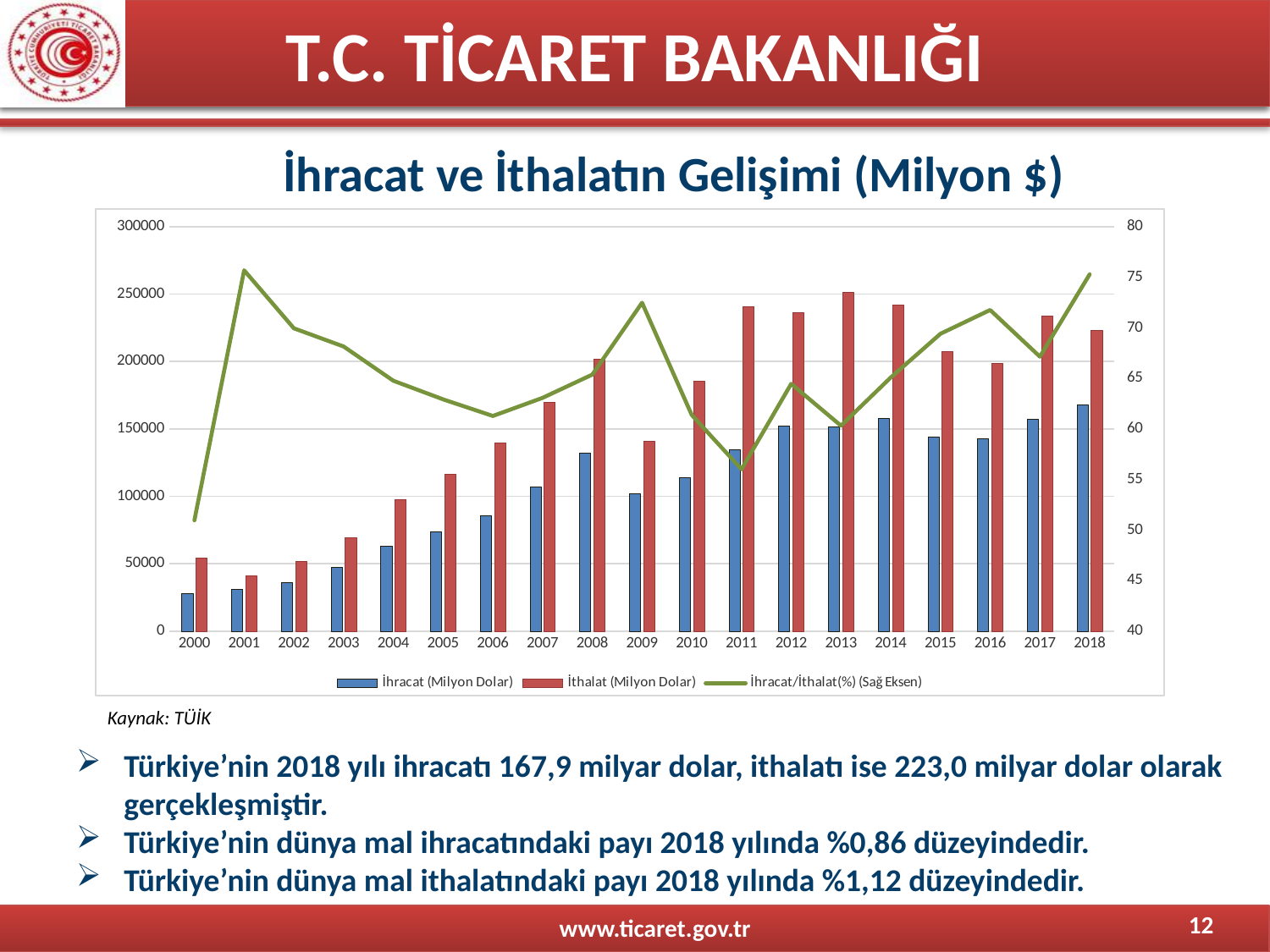
How many series does the legend list? 3 Is the İhracat/İthalat(%) value for 2011 greater or less than 60? less In which year is the İhracat (Milyon Dolar) bar the highest? 2018 What kind of chart is shown on the slide? A combined bar and line chart In which year is the İhracat/İthalat(%) line at its lowest point? 2000 In which year is the İthalat (Milyon Dolar) bar the highest? 2013 Is the İthalat (Milyon Dolar) value for 2009 greater or less than 150000? less How many years are shown on the x axis? 19 In which year is the İhracat (Milyon Dolar) bar the lowest? 2000 Do the İhracat (Milyon Dolar) bars rise or fall from 2000 to 2008? rise Which is larger, the İthalat (Milyon Dolar) bar for 2013 or for 2016? 2013 Is the İhracat (Milyon Dolar) value for 2018 greater or less than 150000? greater